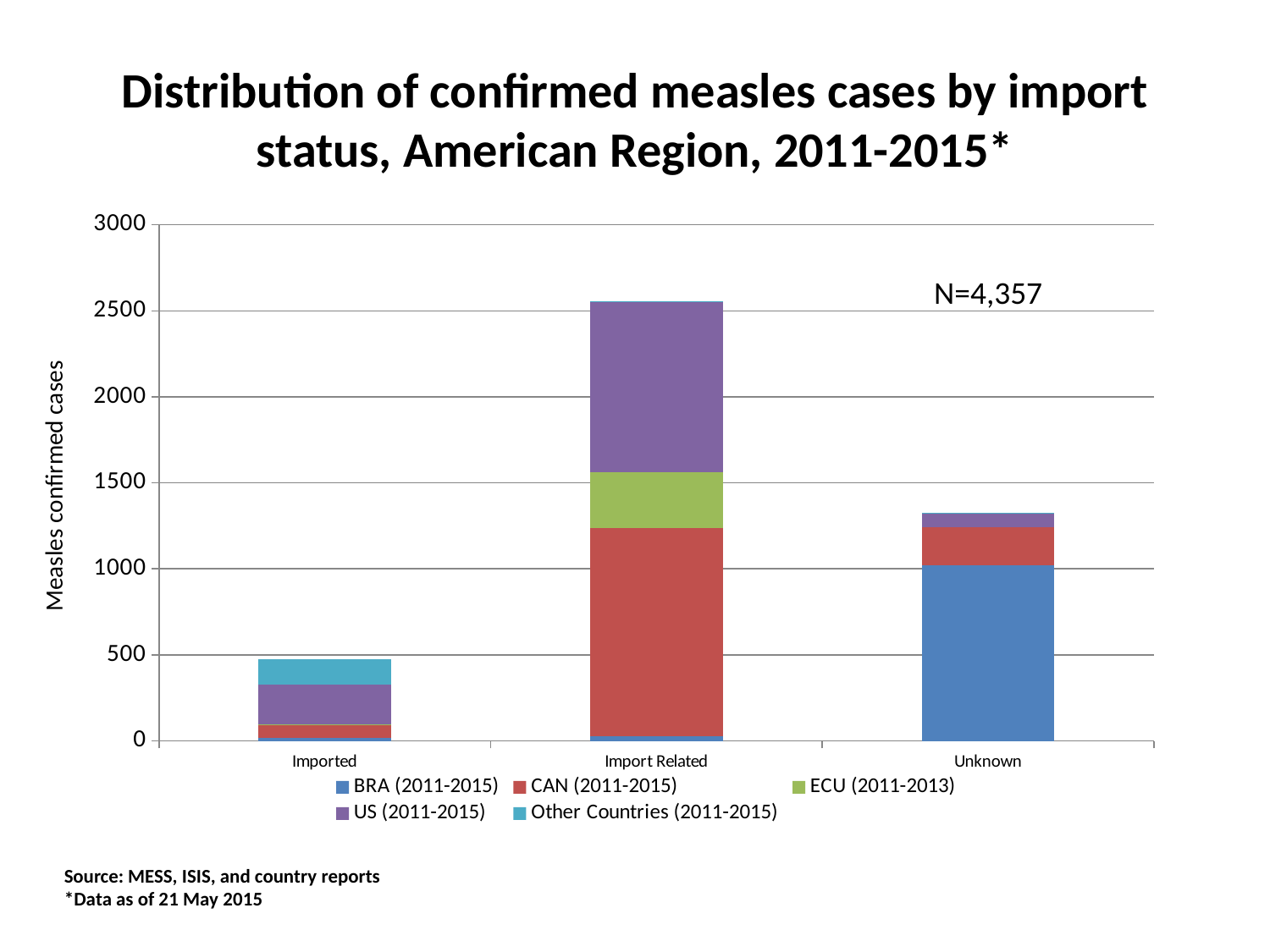
Is the CAN (2011-2015) segment in the Import Related bar greater or less than 1000? greater Is the total value for Unknown greater or less than 1500? less Which import status category has the lowest total number of confirmed measles cases? Imported How many series does the legend list? 5 What total N is stated on the chart? N=4,357 Is the total value for Imported greater or less than 1000? less What type of chart is shown on the slide? Stacked bar chart Which has a larger total of confirmed cases, Unknown or Imported? Unknown Which import status category has the highest total number of confirmed measles cases? Import Related How many import status categories are shown on the x axis? 3 What is the label of the y axis? Measles confirmed cases